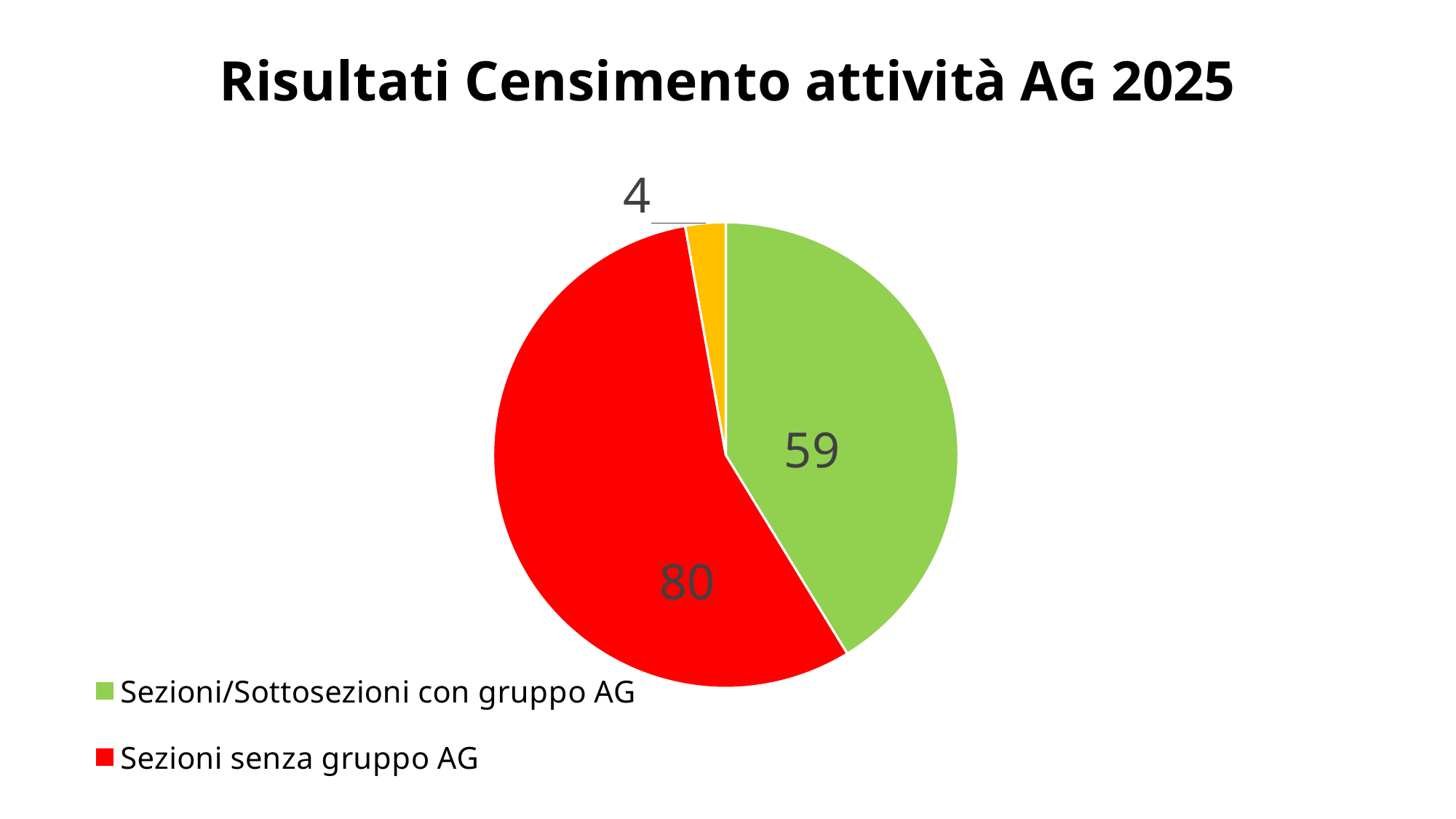
What is the value of the smallest slice in the pie? 4 How many entries does the legend list? 2 What is the title of the chart? Risultati Censimento attività AG 2025 Which is larger: Sezioni senza gruppo AG or Sezioni/Sottosezioni con gruppo AG? Sezioni senza gruppo AG What is the difference between the values for Sezioni senza gruppo AG and Sezioni/Sottosezioni con gruppo AG? 21 How many slices does the pie chart have? 3 What is the total of all the slice values shown on the pie? 143 What is the value for Sezioni/Sottosezioni con gruppo AG? 59 What type of chart is shown on the slide? pie chart Which legend category has the largest slice of the pie? Sezioni senza gruppo AG What colour is the slice for Sezioni senza gruppo AG? red What is the value for Sezioni senza gruppo AG? 80